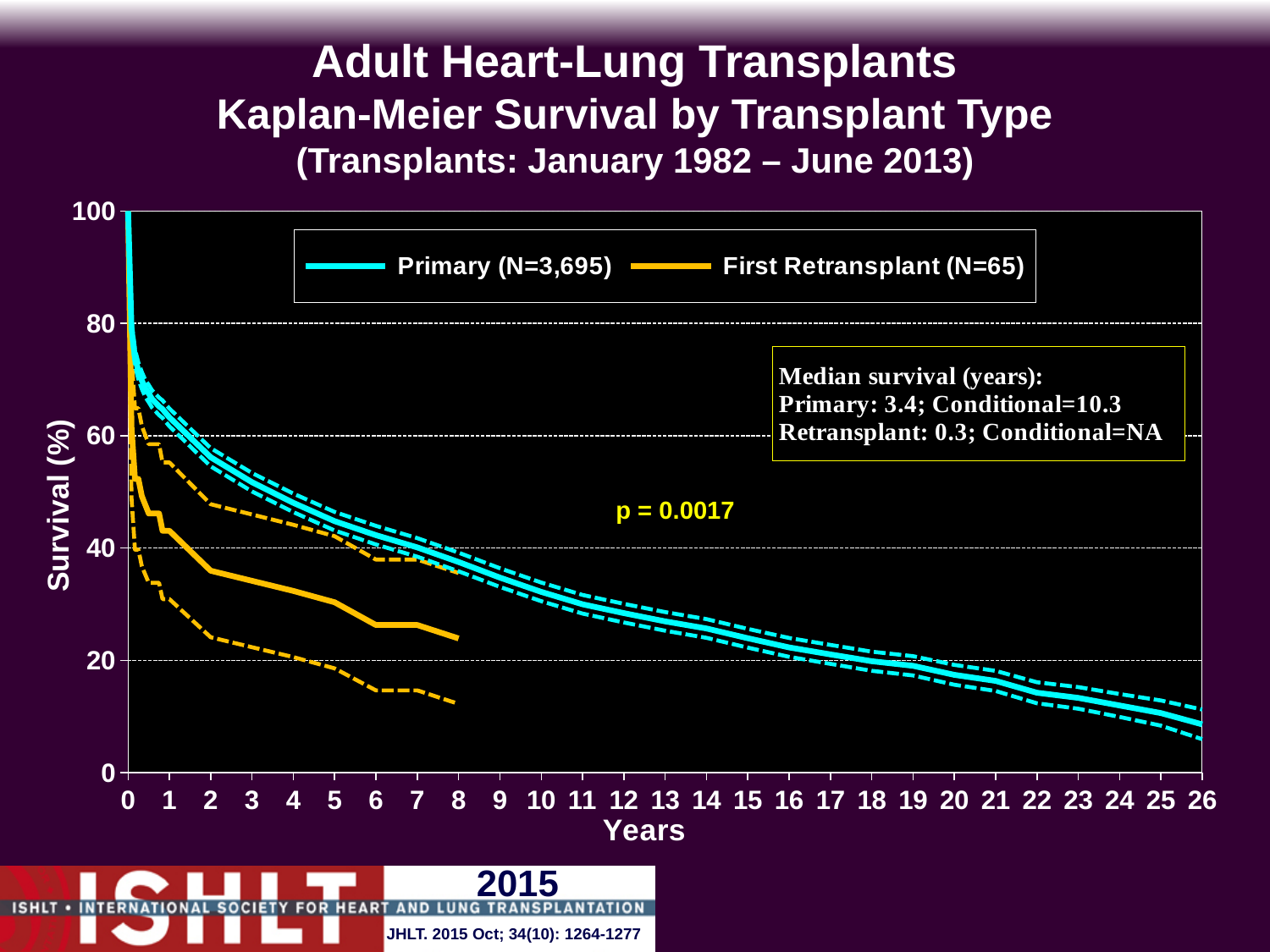
How many series does the legend list? 2 What is the conditional median survival in years for Primary transplants? 10.3 What is the median survival in years for Retransplants? 0.3 Do the survival curves rise or fall as years increase? fall Is the Primary survival at 10 years greater or less than 40%? less Is the Primary survival at 5 years greater or less than 40%? greater At 5 years, which group has the higher survival, Primary or First Retransplant? Primary What is the sample size (N) for the Primary transplant group? 3,695 What is the median survival in years for Primary transplants? 3.4 What p-value is shown on the chart? p = 0.0017 What is the sample size (N) for the First Retransplant group? 65 What kind of chart is shown on the slide? Line chart (Kaplan-Meier survival curve)